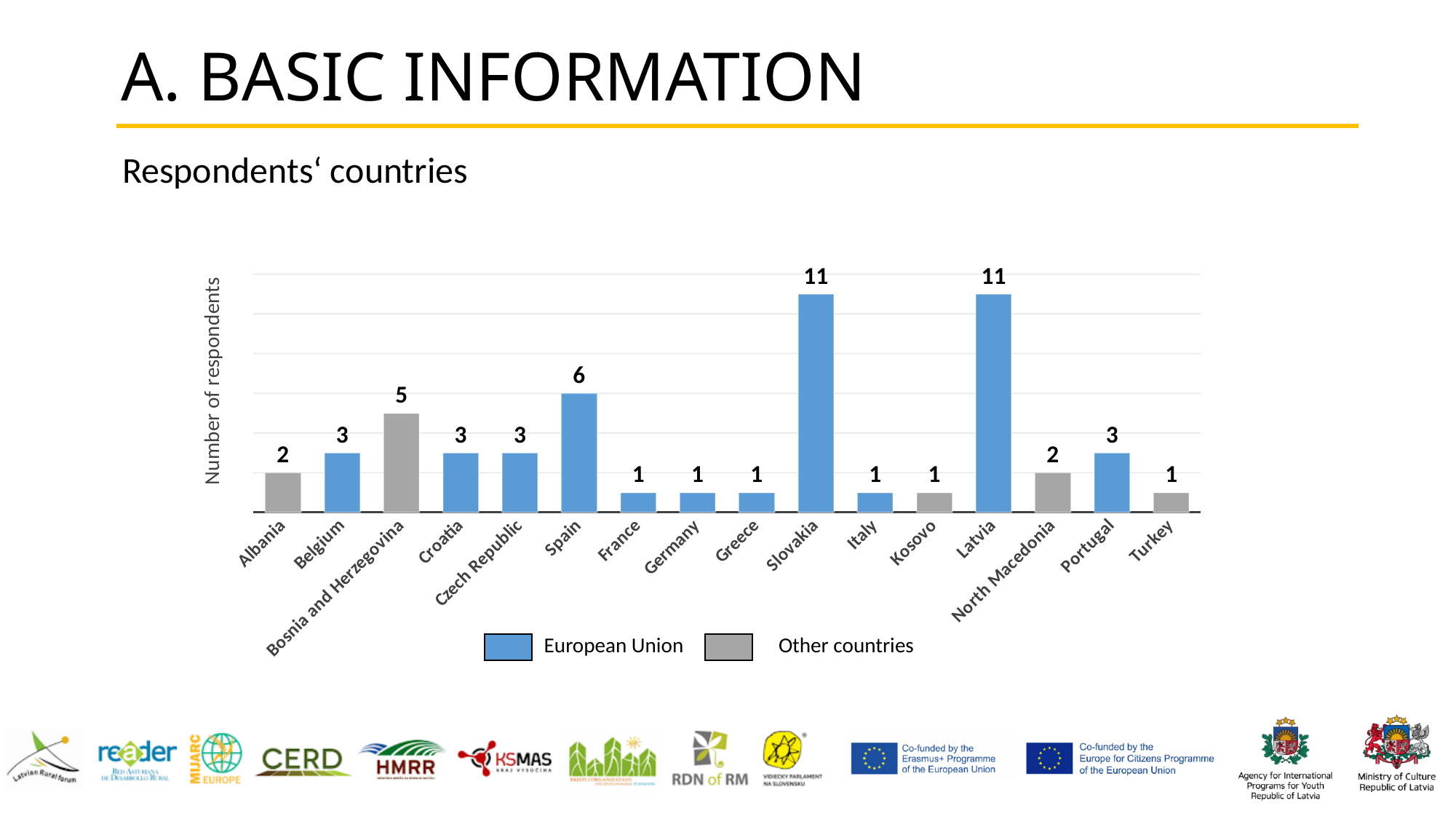
What type of chart is used to show the respondents' countries? Bar chart Which has more respondents, Belgium or Bosnia and Herzegovina? Bosnia and Herzegovina What is the label of the vertical axis? Number of respondents How many countries are shown on the x axis of the chart? 16 How many respondents are from Bosnia and Herzegovina? 5 Which countries have the highest number of respondents? Slovakia and Latvia What is the difference in number of respondents between Bosnia and Herzegovina and Albania? 3 What is the difference in number of respondents between Slovakia and Spain? 5 How many respondents are from Spain? 6 Which has more respondents, Portugal or Turkey? Portugal What is the number of respondents for North Macedonia? 2 How many entries does the legend list? 2